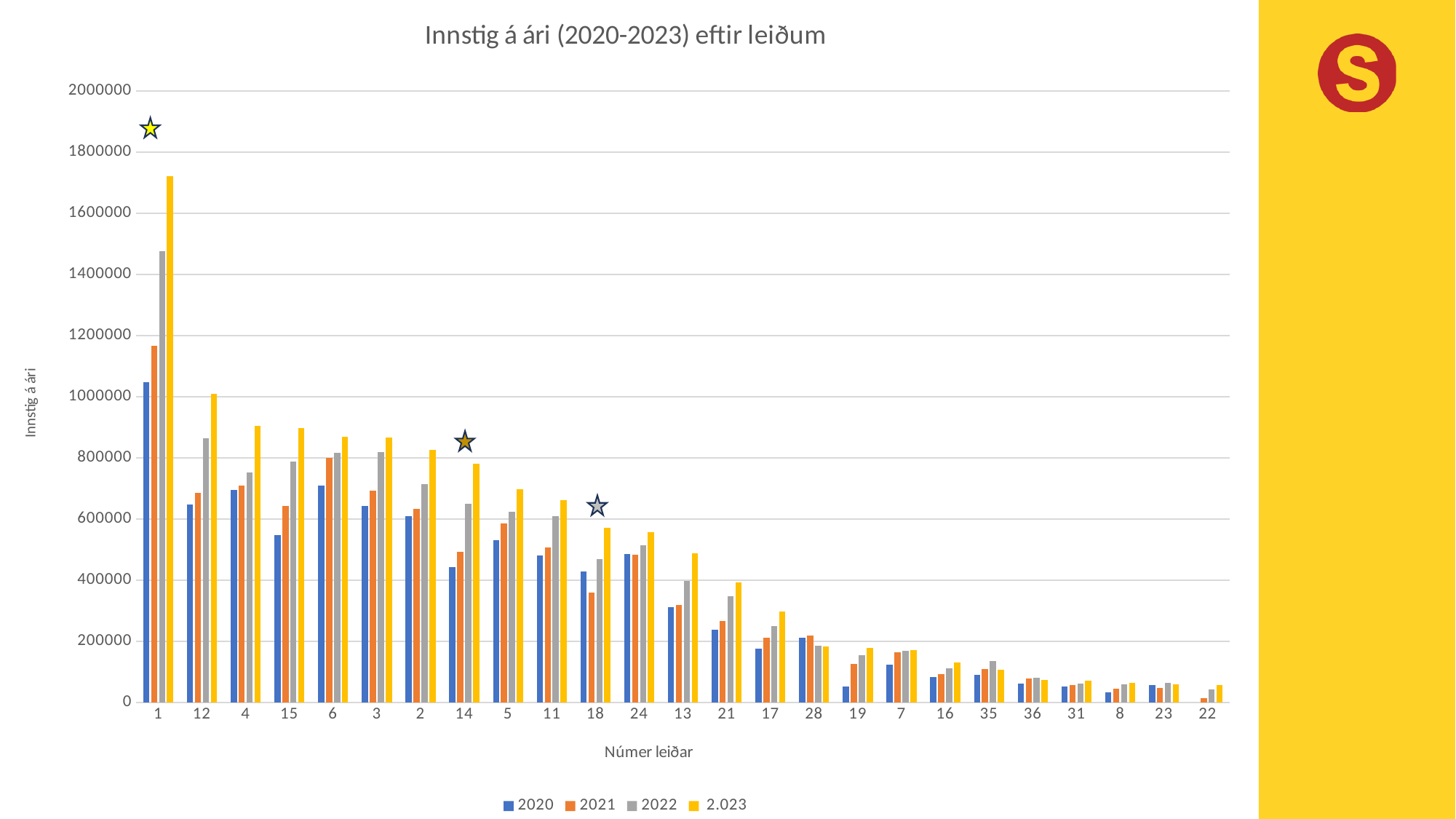
What kind of chart is shown on the slide? bar chart How many series does the legend list? 4 Is the 2.023 value for route 4 greater or less than 800000? greater Do the 2.023 values generally rise or fall moving from left to right along the x axis? fall Which route has the lowest values overall? 22 For route 18, which is larger: the 2021 value or the 2022 value? 2022 Is the 2021 value for route 18 greater or less than 400000? less Is the 2.023 value for route 1 greater or less than 1600000? greater How many route categories are shown on the x axis? 25 Which route has the highest value for the 2.023 series? 1 What is the title of the chart? Innstig á ári (2020-2023) eftir leiðum